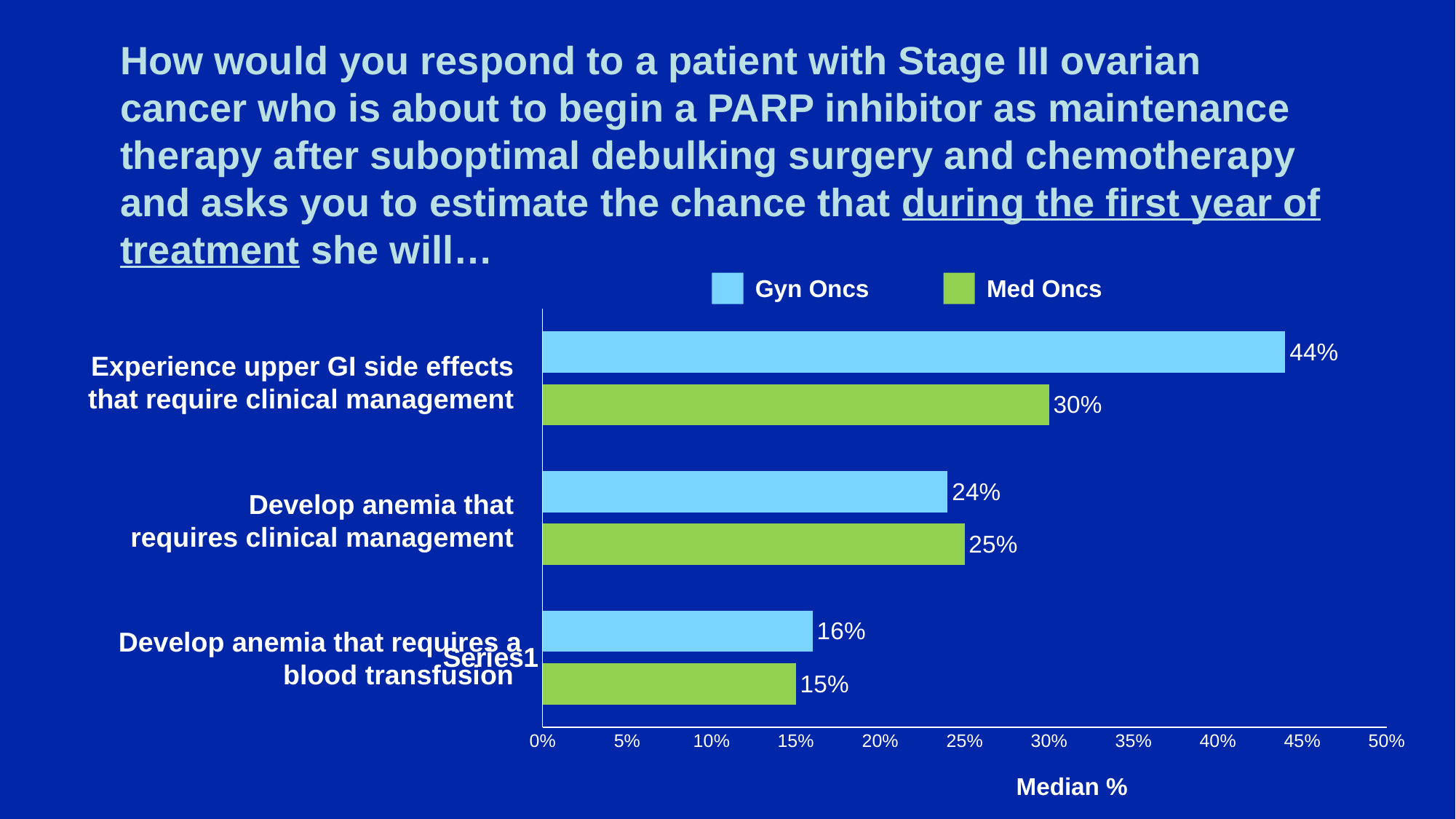
How many series does the legend list? 2 Is the Gyn Oncs value for "Develop anemia that requires a blood transfusion" greater or less than 20%? less Which category has the highest Gyn Oncs value? Experience upper GI side effects that require clinical management What is the Gyn Oncs value for "Experience upper GI side effects that require clinical management"? 44% What is the label of the horizontal axis? Median % What is the Med Oncs value for "Develop anemia that requires clinical management"? 25% Which category has the lowest Med Oncs value? Develop anemia that requires a blood transfusion What kind of chart is shown on the slide? Bar chart What is the difference between the Gyn Oncs and Med Oncs values for "Experience upper GI side effects that require clinical management"? 14% What is the Med Oncs value for "Develop anemia that requires a blood transfusion"? 15% For "Develop anemia that requires clinical management", which series has the larger value, Gyn Oncs or Med Oncs? Med Oncs How many categories are shown on the chart? 3